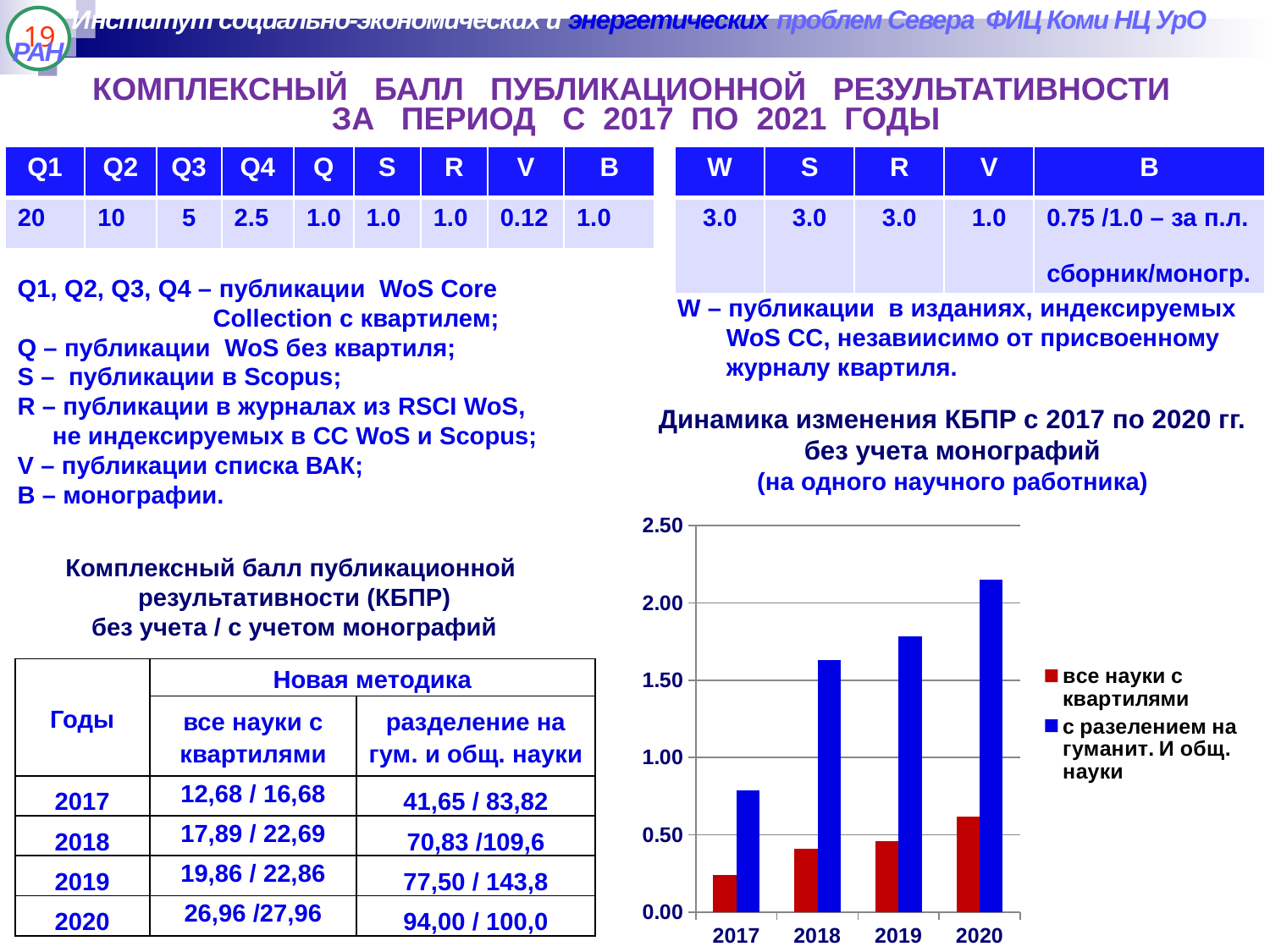
What kind of chart is shown on the slide? bar chart Is the 2020 value for 'все науки с квартилями' greater or less than 0.50? greater How many years are shown on the x axis of the chart? 4 Which year has the highest value for the series 'с разелением на гуманит. И общ. науки'? 2020 Which year has the lowest value for the series 'все науки с квартилями'? 2017 How many series does the chart legend list? 2 Is the 2017 value for 'с разелением на гуманит. И общ. науки' greater or less than 1.00? less Is the 2020 value for 'с разелением на гуманит. И общ. науки' greater or less than 2.00? greater Do the values for the series 'с разелением на гуманит. И общ. науки' rise or fall from 2017 to 2020? rise In 2018, which series has the larger value: 'все науки с квартилями' or 'с разелением на гуманит. И общ. науки'? с разелением на гуманит. И общ. науки What colour are the bars for the series 'все науки с квартилями'? red